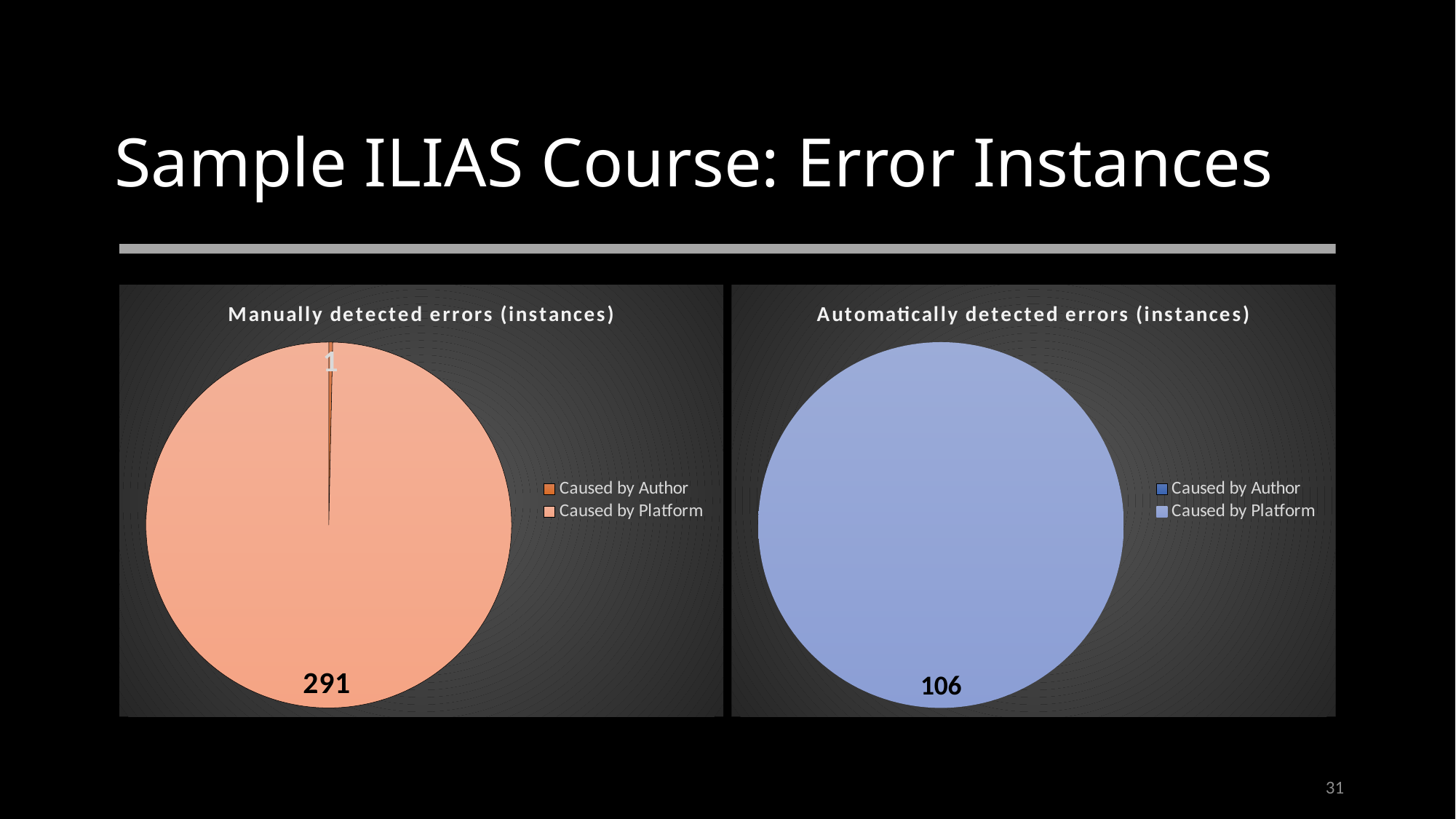
How many pie charts are shown on the slide? 2 How many series does the legend of the 'Manually detected errors (instances)' chart list? 2 What is the title of the chart on the right side of the slide? Automatically detected errors (instances) In the 'Manually detected errors (instances)' chart, what is the value for Caused by Author? 1 In the 'Manually detected errors (instances)' chart, which is larger: Caused by Author or Caused by Platform? Caused by Platform In the 'Manually detected errors (instances)' chart, what is the value for Caused by Platform? 291 In the 'Automatically detected errors (instances)' chart, what is the value for Caused by Platform? 106 In the 'Manually detected errors (instances)' chart, what is the difference between the Caused by Platform and Caused by Author values? 290 In the 'Manually detected errors (instances)' chart, which category has the largest slice? Caused by Platform What type of chart is the 'Automatically detected errors (instances)' chart? Pie chart In the 'Automatically detected errors (instances)' chart, what colour is the Caused by Platform slice? Blue In the 'Manually detected errors (instances)' chart, which category has the smallest slice? Caused by Author